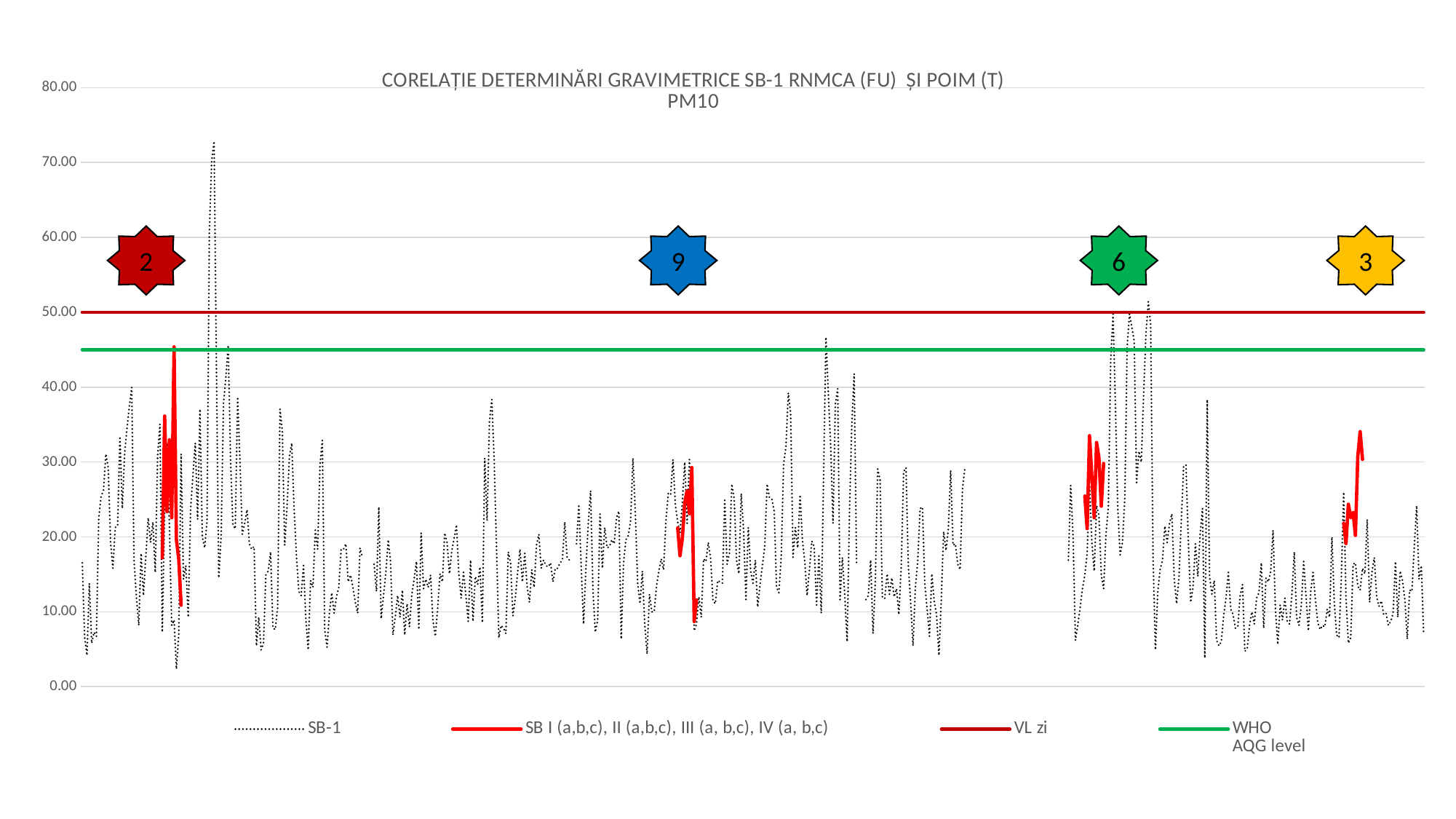
Is the highest value of the SB I (a,b,c), II (a,b,c), III (a, b,c), IV (a, b,c) series greater or less than 50? less Which is higher on the chart, the VL zi line or the WHO AQG level line? VL zi What value does the VL zi line sit at on the y axis? 50.00 What is the title of the chart? CORELAȚIE DETERMINĂRI GRAVIMETRICE SB-1 RNMCA (FU) ȘI POIM (T) PM10 Is the WHO AQG level line greater or less than 50? less Which series reaches the highest value on the chart? SB-1 Is the highest peak of the SB-1 series greater or less than 70? greater What colour is the WHO AQG level line? green How many series does the legend list? 4 What kind of chart is shown on the slide? line chart